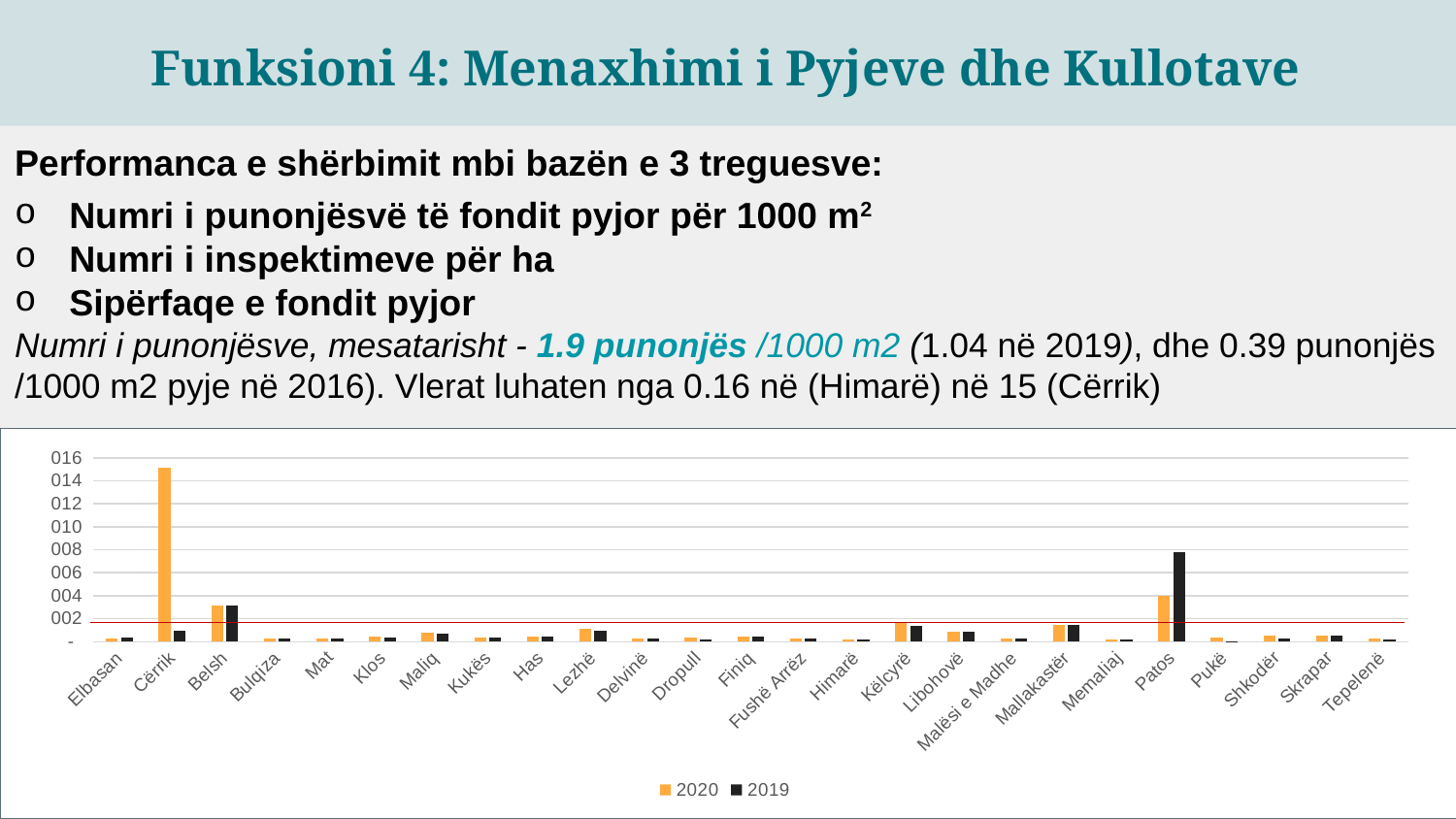
Is the 2020 value for Belsh greater or less than 002? greater Which colour represents the 2019 series in the chart? black What kind of chart is shown on the slide? bar chart Which municipality has the highest 2019 value in the chart? Patos Which municipality has the highest 2020 value in the chart? Cërrik For Cërrik, which year has the larger value, 2019 or 2020? 2020 Is the 2020 value for Cërrik greater or less than 014? greater How many series does the chart legend list? 2 Is the 2019 value for Patos greater or less than 006? greater For Patos, which year has the larger value, 2019 or 2020? 2019 Which is larger, the 2020 value for Cërrik or the 2020 value for Patos? Cërrik How many municipalities (categories) are shown on the x axis of the chart? 25